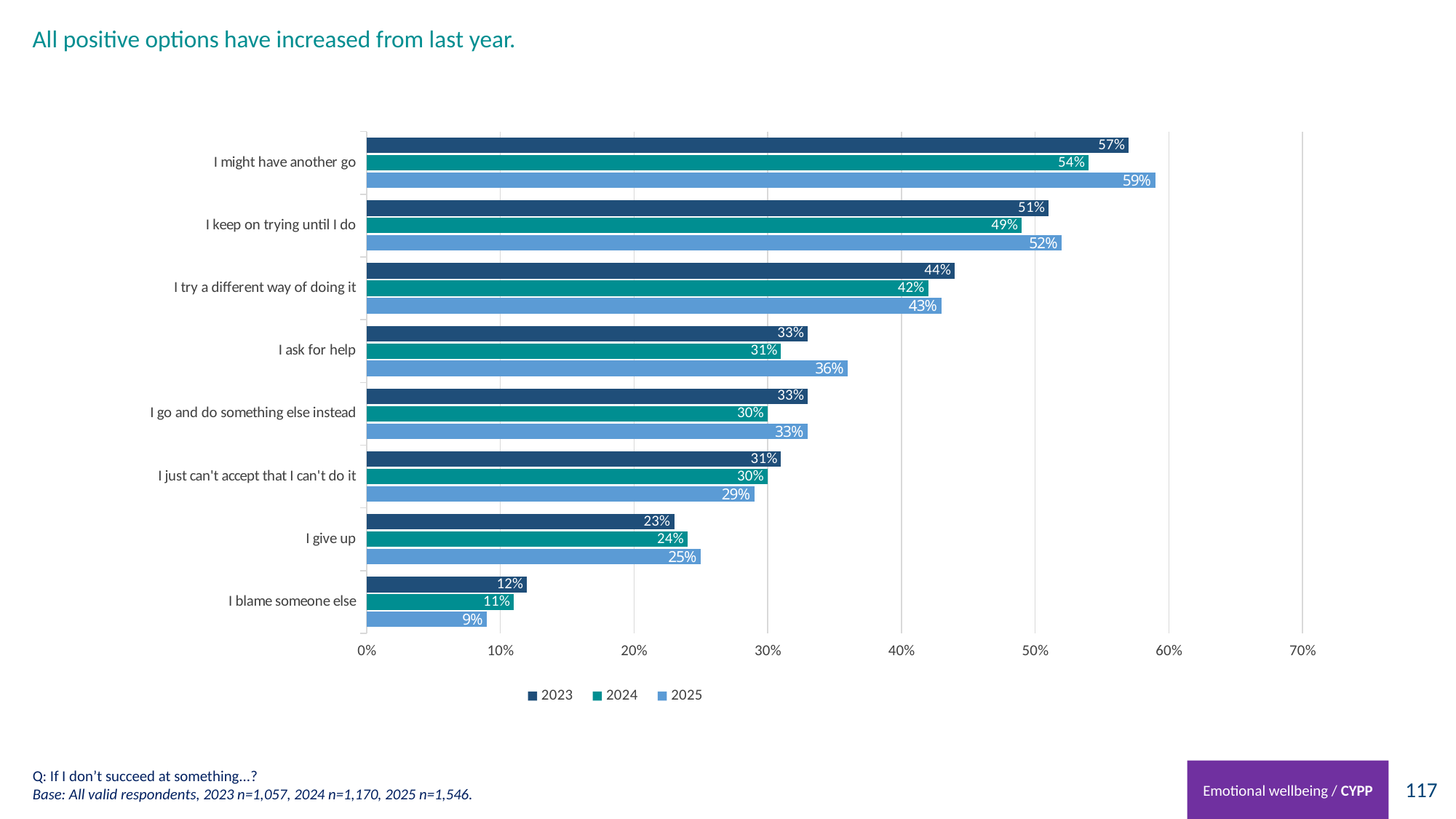
What is the difference between the 2023 and 2025 values for "I blame someone else"? 3% How many series does the legend list? 3 Which series is shown in the darkest blue colour? 2023 What is the 2024 value for "I ask for help"? 31% Which is larger for "I give up": the 2023 value or the 2025 value? 2025 What is the 2025 value for "I might have another go"? 59% What is the 2023 value for "I blame someone else"? 12% Which category has the highest 2025 value? I might have another go Which category has the lowest 2024 value? I blame someone else What kind of chart is shown on the slide? Bar chart What is the difference between the 2025 and 2024 values for "I ask for help"? 5% How many categories are shown on the chart? 8